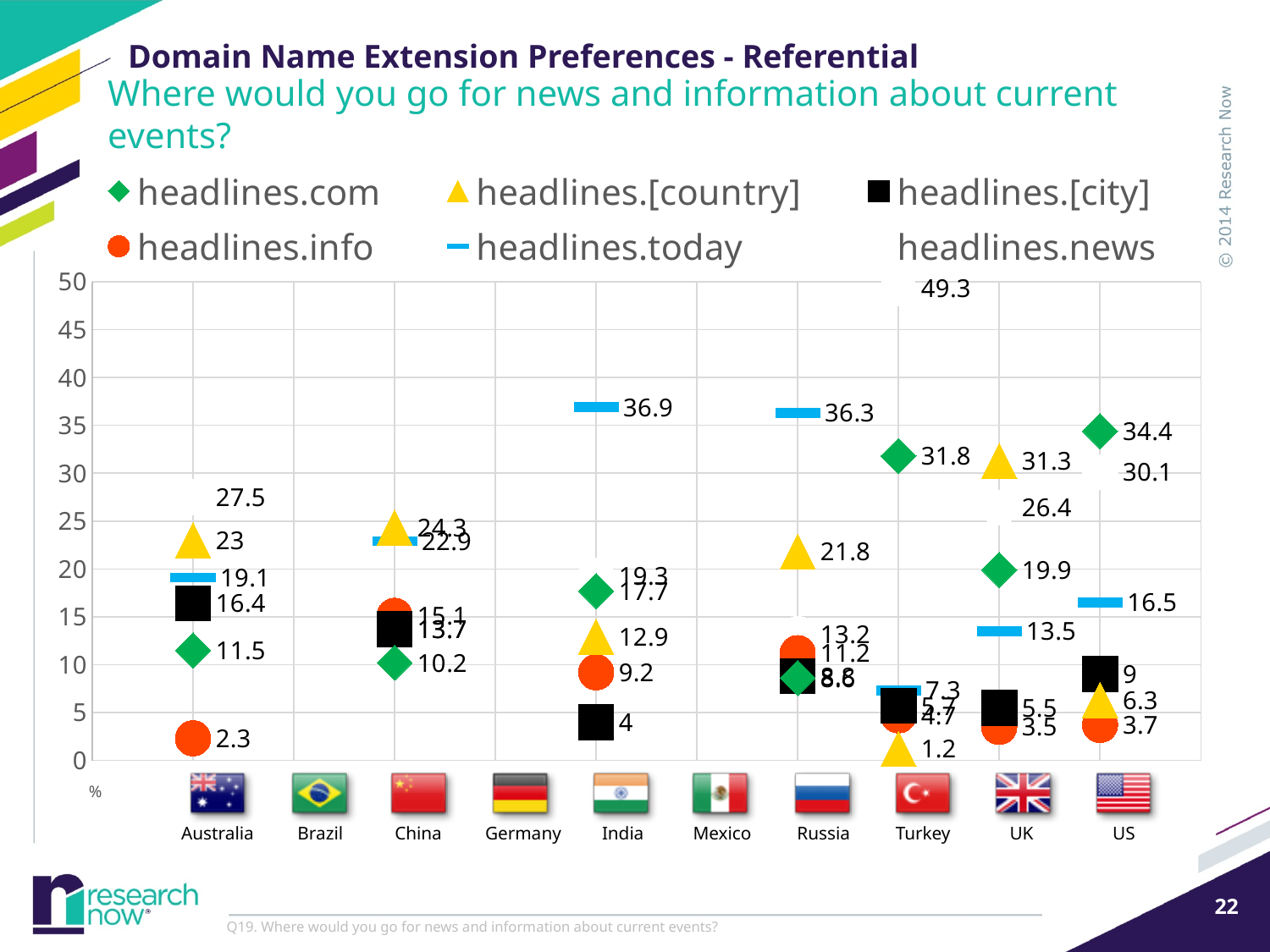
How many countries are shown along the x axis? 10 What is the value for headlines.[country] in the UK? 31.3 What is the value for headlines.com in the US? 34.4 Which country has the highest value for headlines.com? US Which countries on the x axis have no data points plotted? Brazil, Germany, Mexico How many series does the legend list? 6 What is the value for headlines.today in India? 36.9 Which is larger, the headlines.[country] value for Australia or for the UK? UK What is the value for headlines.info in Australia? 2.3 What kind of chart is shown on the slide? scatter chart Which series has the lowest value in Turkey? headlines.[country] What is the difference between the headlines.com values for the US and the UK? 14.5